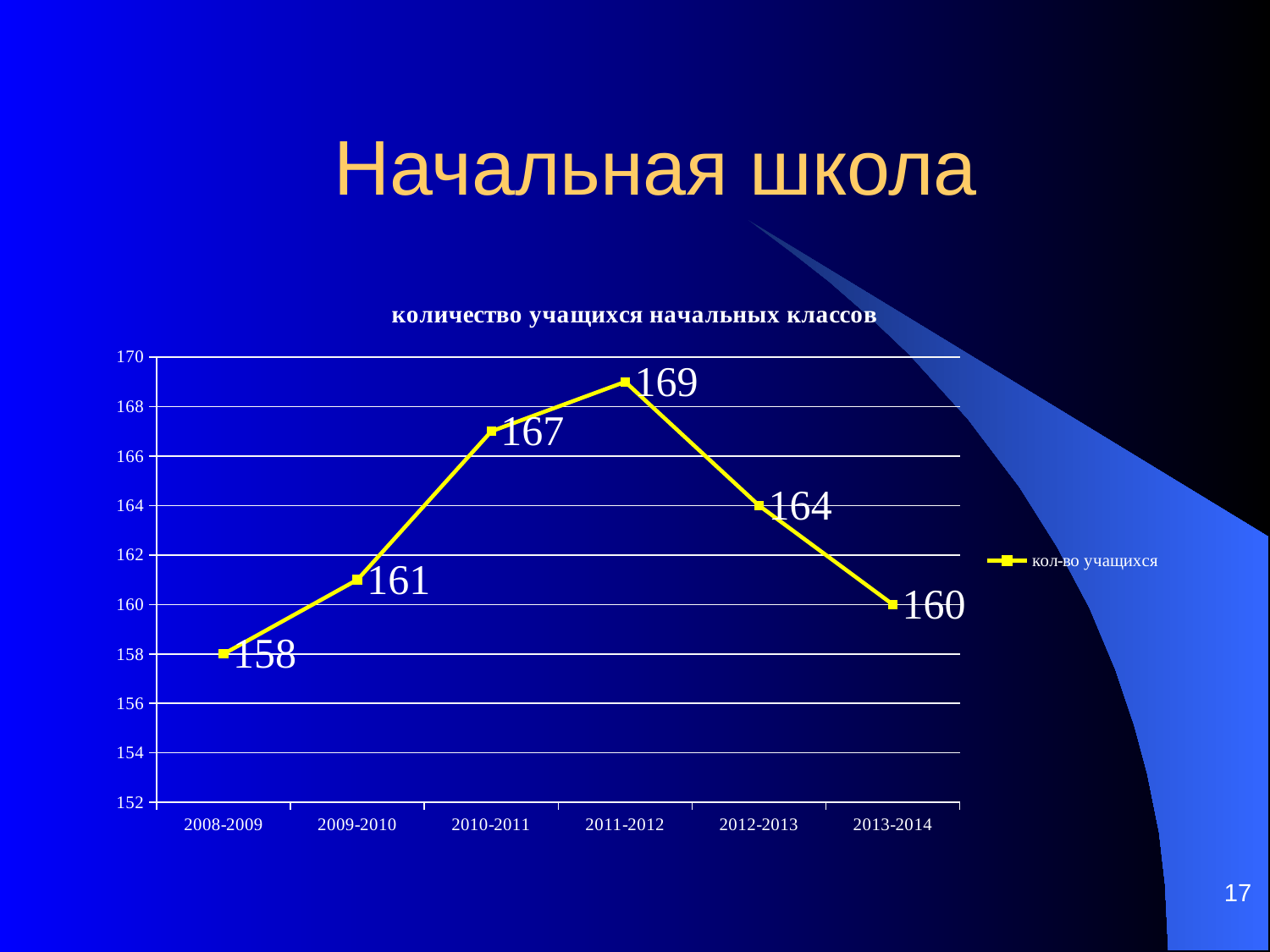
What is the number of students for 2008-2009? 158 What is the number of students for 2011-2012? 169 What is the number of students for 2013-2014? 160 What is the difference between the values for 2011-2012 and 2013-2014? 9 What is the difference between the values for 2010-2011 and 2009-2010? 6 How many school years are plotted on the chart? 6 What is the title of the chart? количество учащихся начальных классов What kind of chart is shown on the slide? line chart How many series does the legend list? 1 Which is larger, the value for 2012-2013 or the value for 2009-2010? 2012-2013 Which school year has the highest number of students? 2011-2012 Which school year has the lowest number of students? 2008-2009